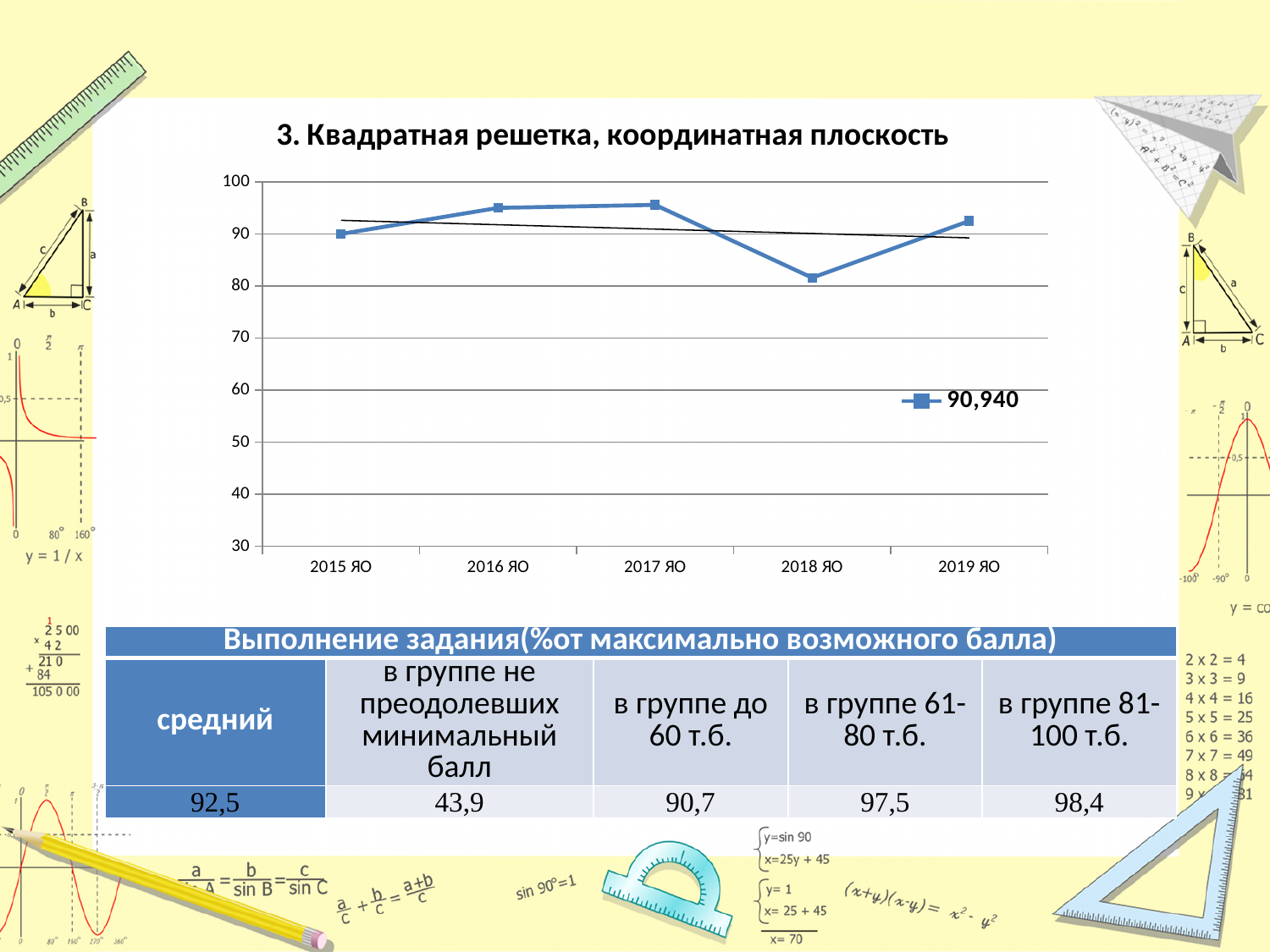
How many data points are plotted along the x axis of the chart? 5 How many series does the chart legend list? 1 What is the legend entry shown for the plotted series? 90,940 Which is larger, the value for 2018 ЯО or the value for 2019 ЯО? 2019 ЯО Which is larger, the value for 2016 ЯО or the value for 2018 ЯО? 2016 ЯО Is the value for 2016 ЯО greater or less than 90? greater What kind of chart is shown on the slide? line chart Does the line rise or fall from 2017 ЯО to 2018 ЯО? fall Is the value for 2018 ЯО greater or less than 90? less Is the value for 2017 ЯО greater or less than 90? greater Which year has the lowest value on the chart? 2018 ЯО What is the title of the chart? 3. Квадратная решетка, координатная плоскость